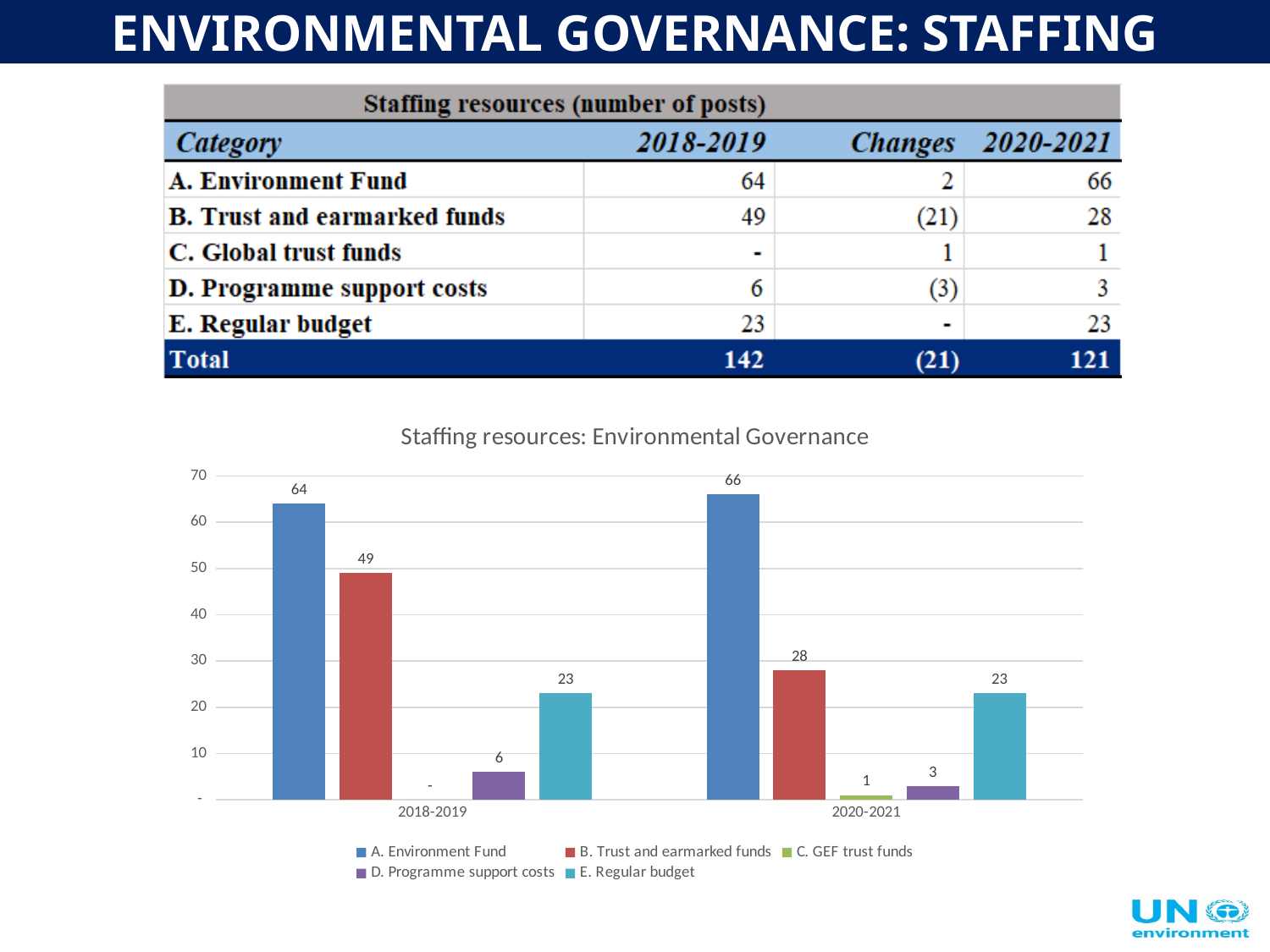
Which is larger: A. Environment Fund in 2018-2019 or A. Environment Fund in 2020-2021? 2020-2021 What is the value for D. Programme support costs in 2018-2019? 6 Which series has the lowest value in 2020-2021? C. GEF trust funds What is the title of the chart? Staffing resources: Environmental Governance What is the value for A. Environment Fund in 2018-2019? 64 What is the value for B. Trust and earmarked funds in 2020-2021? 28 How many series does the legend list? 5 What kind of chart is shown? Bar chart What is the value for C. GEF trust funds in 2020-2021? 1 What is the difference between B. Trust and earmarked funds in 2018-2019 and in 2020-2021? 21 Is the value for B. Trust and earmarked funds in 2018-2019 greater or less than 40? greater Which series has the highest value in 2020-2021? A. Environment Fund